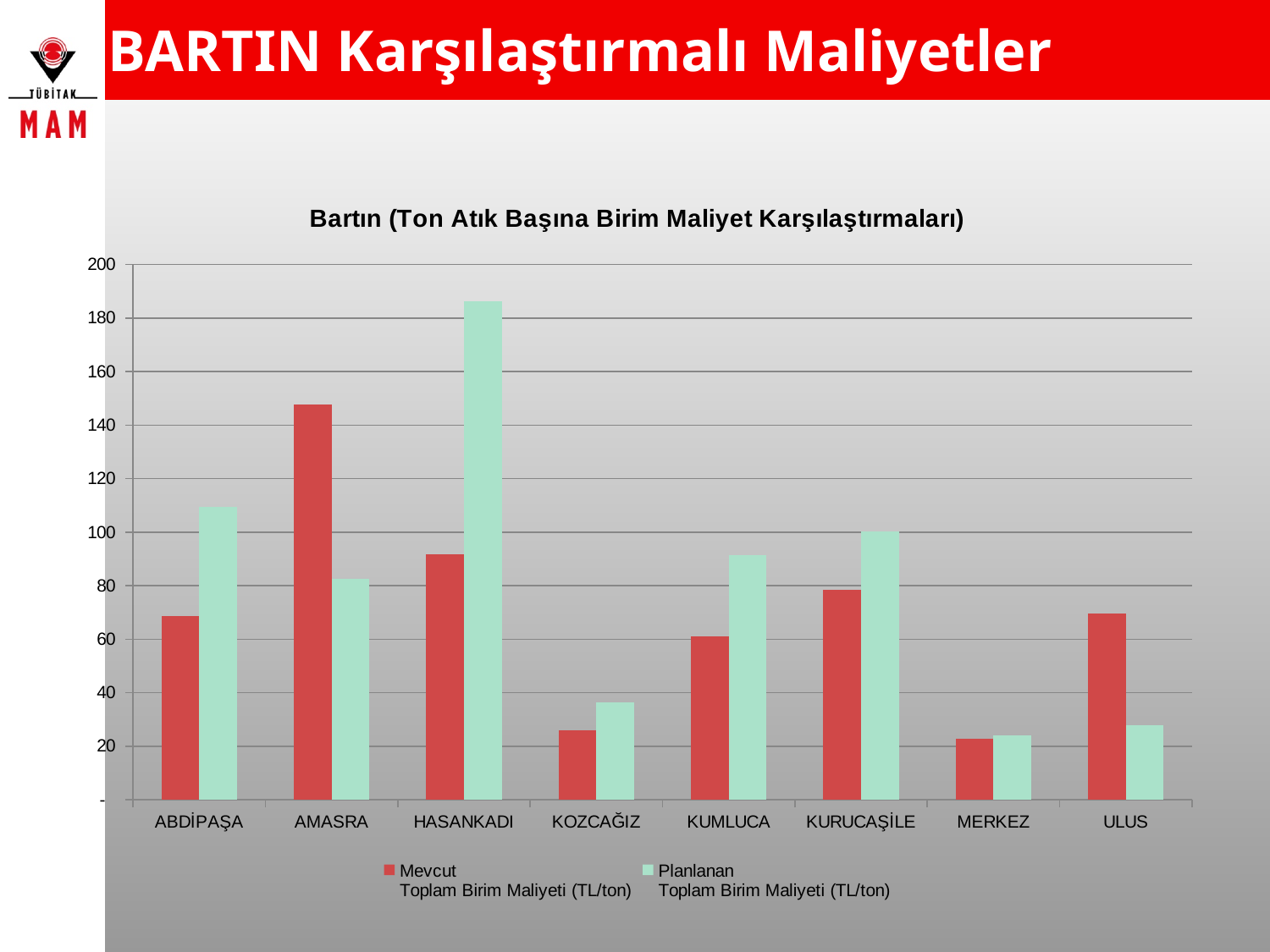
Is the Mevcut Toplam Birim Maliyeti for AMASRA greater or less than 140? greater Is the Planlanan Toplam Birim Maliyeti for HASANKADI greater or less than 180? greater For ULUS, which is larger: the Mevcut or the Planlanan Toplam Birim Maliyeti? Mevcut For AMASRA, which is larger: the Mevcut or the Planlanan Toplam Birim Maliyeti? Mevcut What type of chart is shown on the slide? bar chart Is the Mevcut Toplam Birim Maliyeti for KOZCAĞIZ greater or less than 40? less What is the title of the chart? Bartın (Ton Atık Başına Birim Maliyet Karşılaştırmaları) How many categories (districts) are shown on the x axis? 8 Which category has the highest Mevcut Toplam Birim Maliyeti (TL/ton)? AMASRA Which category has the highest Planlanan Toplam Birim Maliyeti (TL/ton)? HASANKADI How many series does the legend list? 2